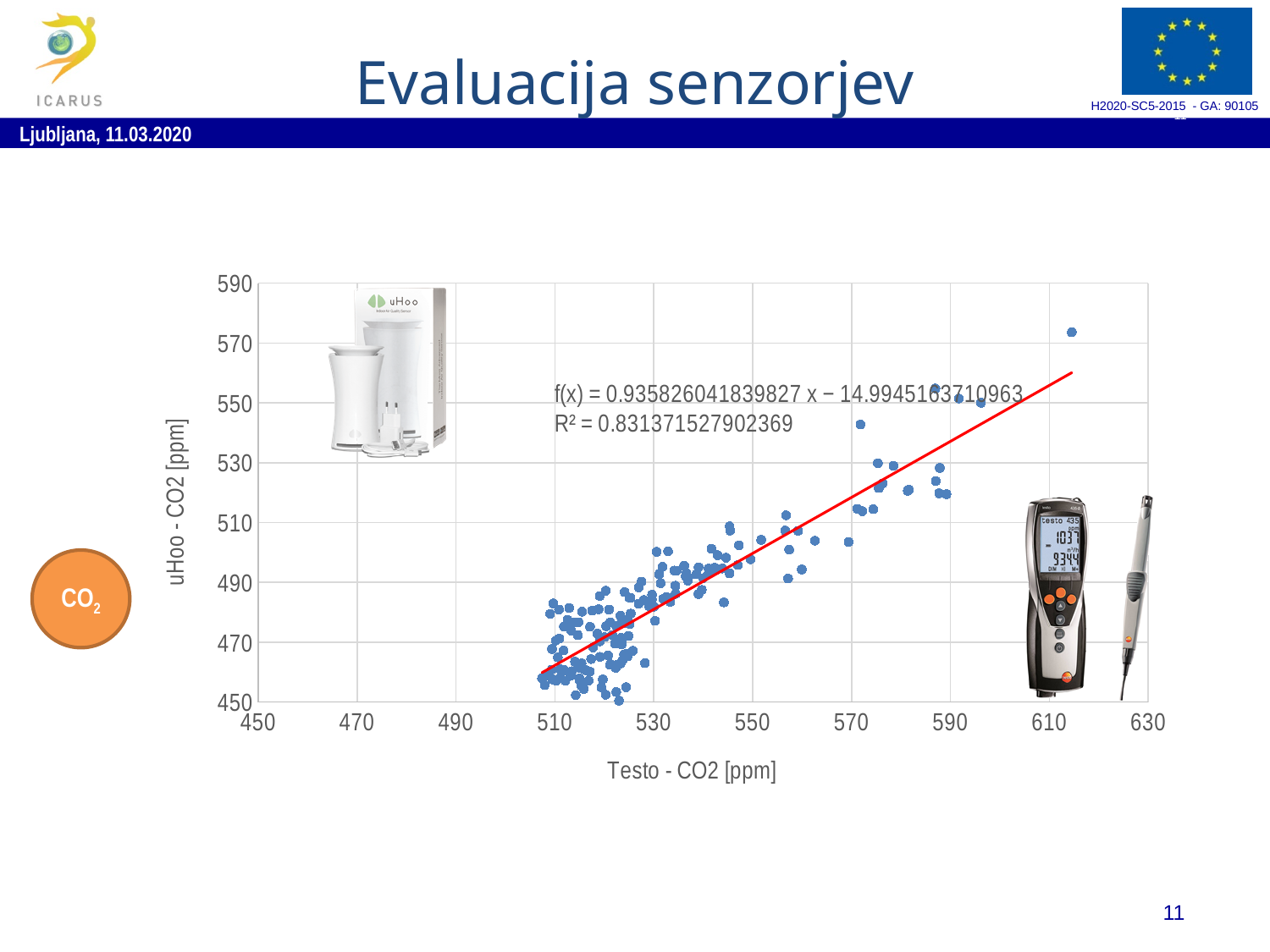
Is the uHoo CO2 value of the lowest data point greater or less than 470? less What is the label of the y axis of the chart? uHoo - CO2 [ppm] Is the uHoo CO2 value of the point with the highest Testo CO2 reading greater or less than 550? greater Do the uHoo CO2 values rise or fall as the Testo CO2 values increase along the x axis? rise What is the label of the x axis of the chart? Testo - CO2 [ppm] What kind of chart is shown on the slide? scatter chart What is the slope of the fitted line shown in the equation on the chart? 0.935826041839827 What is the highest value shown on the x axis of the chart? 630 What R² value is printed on the chart? R² = 0.831371527902369 Is the Testo CO2 value of the leftmost data point greater or less than 490? greater